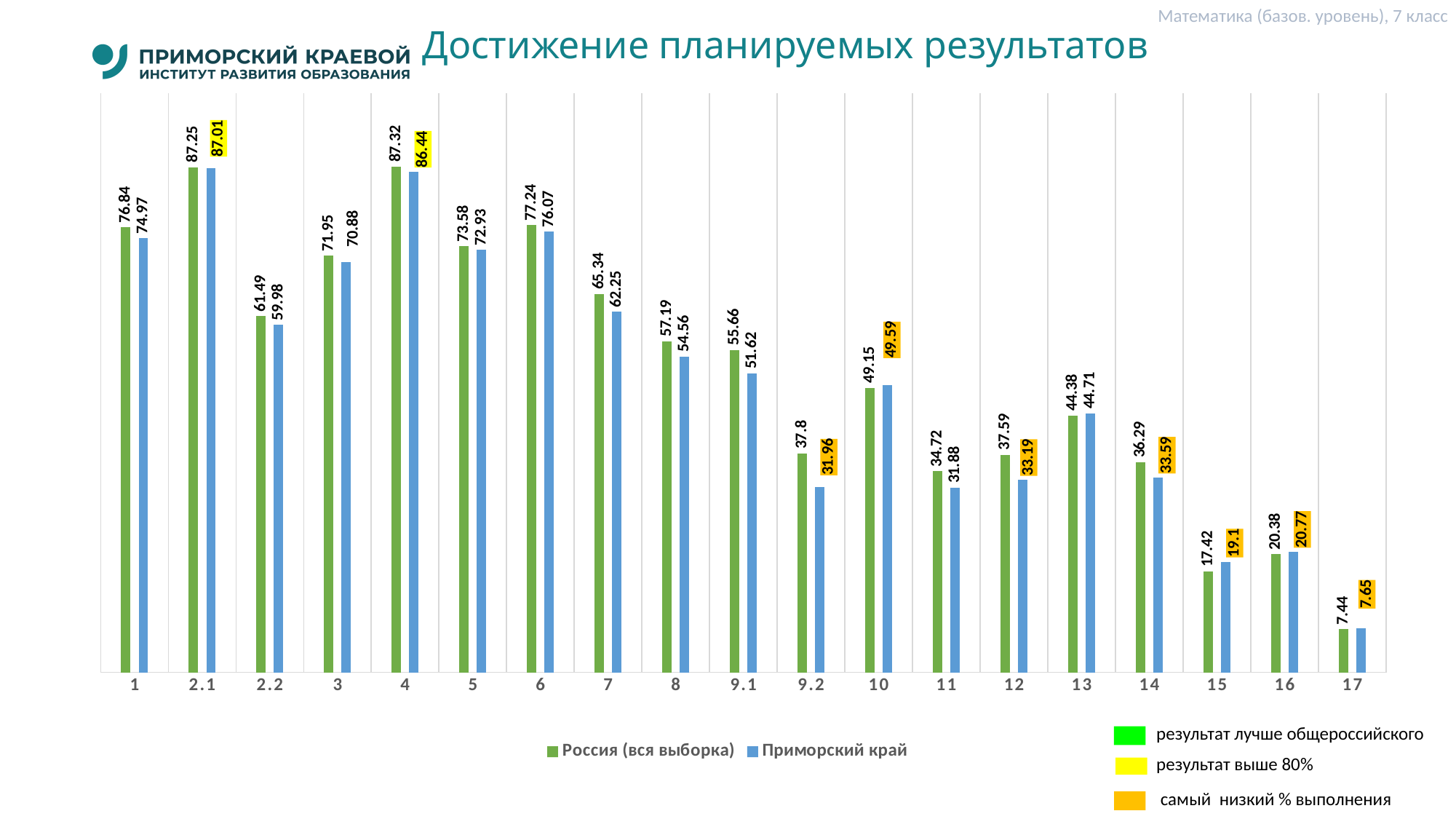
For task 10, which series has the larger value: Россия (вся выборка) or Приморский край? Приморский край What is the value for Приморский край for task 15? 19.1 What is the difference between Россия (вся выборка) and Приморский край for task 9.2? 5.84 What is the value for Россия (вся выборка) for task 2.2? 61.49 What is the difference between Россия (вся выборка) and Приморский край for task 7? 3.09 How many series does the chart legend list? 2 Which task has the highest value for Приморский край? 2.1 What is the value for Россия (вся выборка) for task 9.2? 37.8 How many task categories are shown on the x axis? 19 Which task has the lowest value for Россия (вся выборка)? 17 What kind of chart is shown on the slide? bar chart What is the value for Приморский край for task 4? 86.44